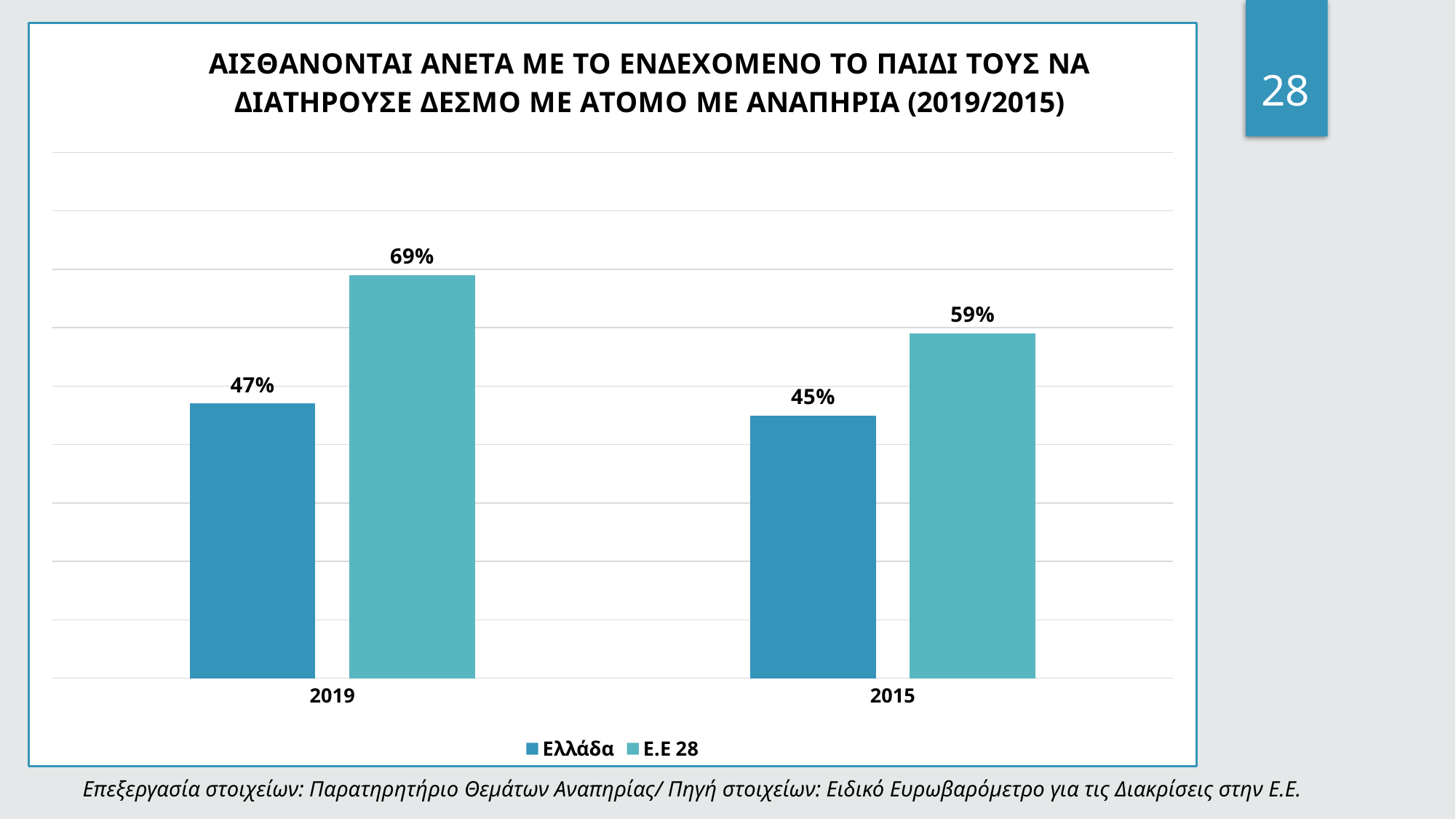
What is the difference between Ε.Ε 28 and Ελλάδα in 2019? 22% What is the value for Ελλάδα in 2019? 47% What is the value for Ε.Ε 28 in 2015? 59% What is the difference between Ε.Ε 28 and Ελλάδα in 2015? 14% What is the value for Ε.Ε 28 in 2019? 69% What is the value for Ελλάδα in 2015? 45% How many series does the legend list? 2 Which bar has the lowest value on the chart? Ελλάδα in 2015 How many categories are shown on the x axis? 2 Which is larger, the Ε.Ε 28 value in 2019 or in 2015? 2019 Which bar has the highest value on the chart? Ε.Ε 28 in 2019 What kind of chart is shown on the slide? Bar chart